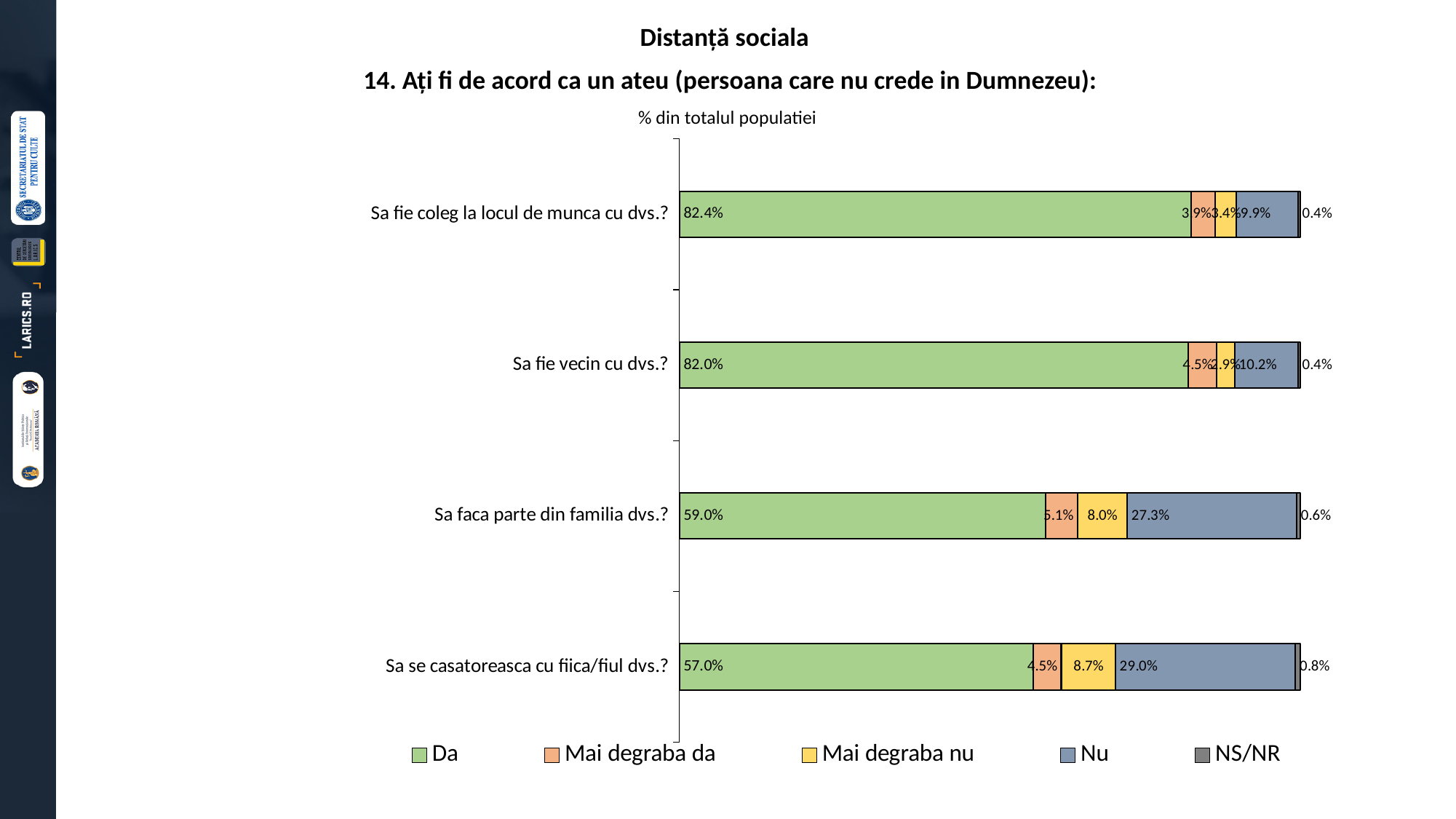
What is the 'Mai degraba nu' value for 'Sa faca parte din familia dvs.?'? 8.0% Which category has the highest 'Da' value? Sa fie coleg la locul de munca cu dvs.? How many series does the legend list? 5 What is the 'Da' value for 'Sa fie coleg la locul de munca cu dvs.?'? 82.4% What is the subtitle shown above the chart? % din totalul populatiei What is the 'Nu' value for 'Sa se casatoreasca cu fiica/fiul dvs.?'? 29.0% What is the 'NS/NR' value for 'Sa fie vecin cu dvs.?'? 0.4% How many categories are plotted on the chart? 4 Which category has the lowest 'Da' value? Sa se casatoreasca cu fiica/fiul dvs.? Which is larger: the 'Nu' value for 'Sa fie vecin cu dvs.?' or the 'Nu' value for 'Sa faca parte din familia dvs.?'? Sa faca parte din familia dvs.? What kind of chart is shown on the slide? Stacked bar chart What is the difference between the 'Nu' values for 'Sa se casatoreasca cu fiica/fiul dvs.?' and 'Sa faca parte din familia dvs.?'? 1.7%